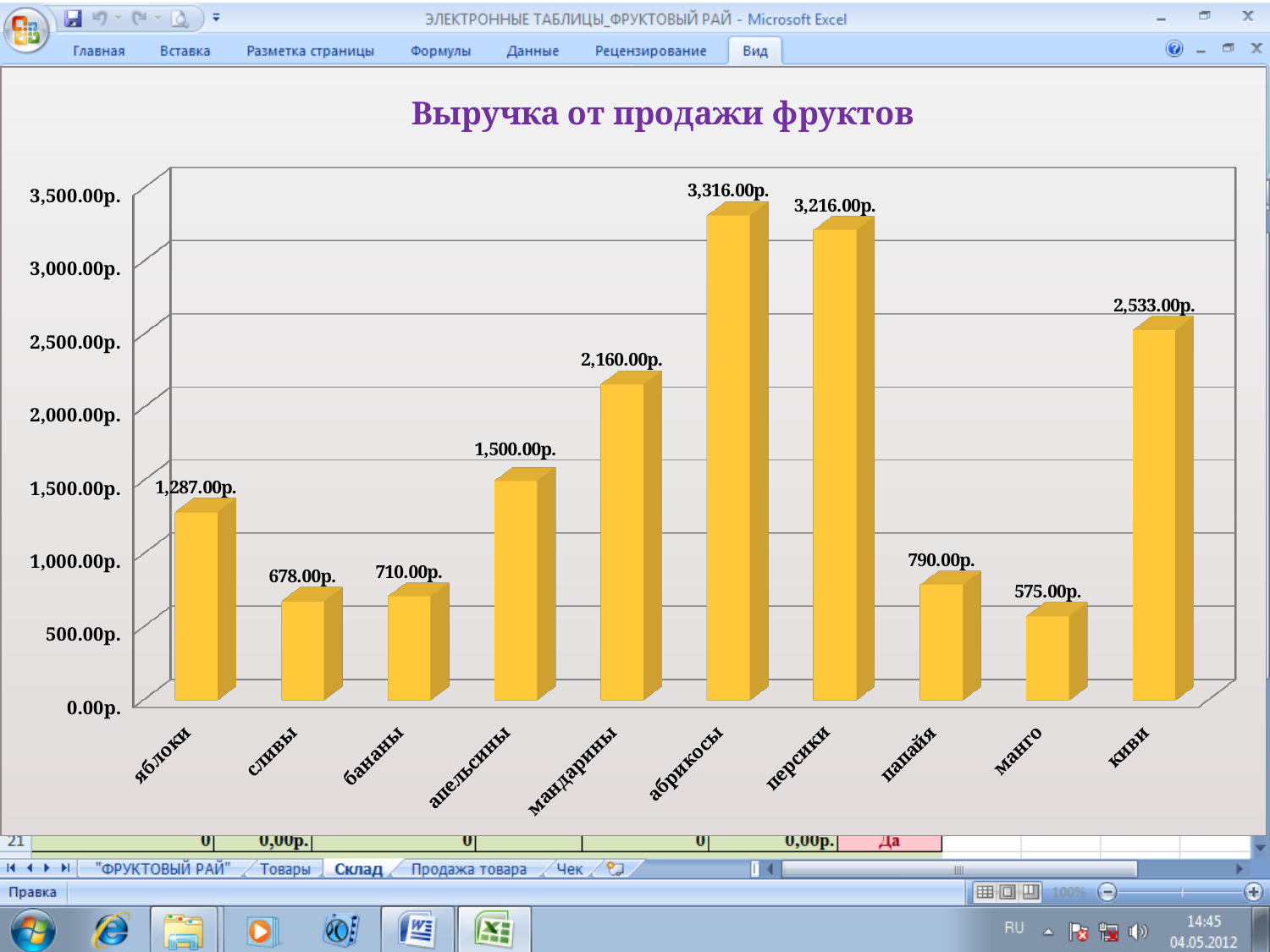
What is the value for яблоки? 1,287.00р. Which is larger, the value for бананы or the value for сливы? бананы What is the difference between the values for абрикосы and персики? 100.00р. What is the difference between the values for киви and мандарины? 373.00р. Is the value for папайя greater or less than 1,000.00р.? less How many categories are shown on the x axis? 10 Which category has the lowest value? манго What is the value for мандарины? 2,160.00р. What is the title of the chart? Выручка от продажи фруктов What kind of chart is shown? bar chart Which category has the highest value? абрикосы What is the value for киви? 2,533.00р.